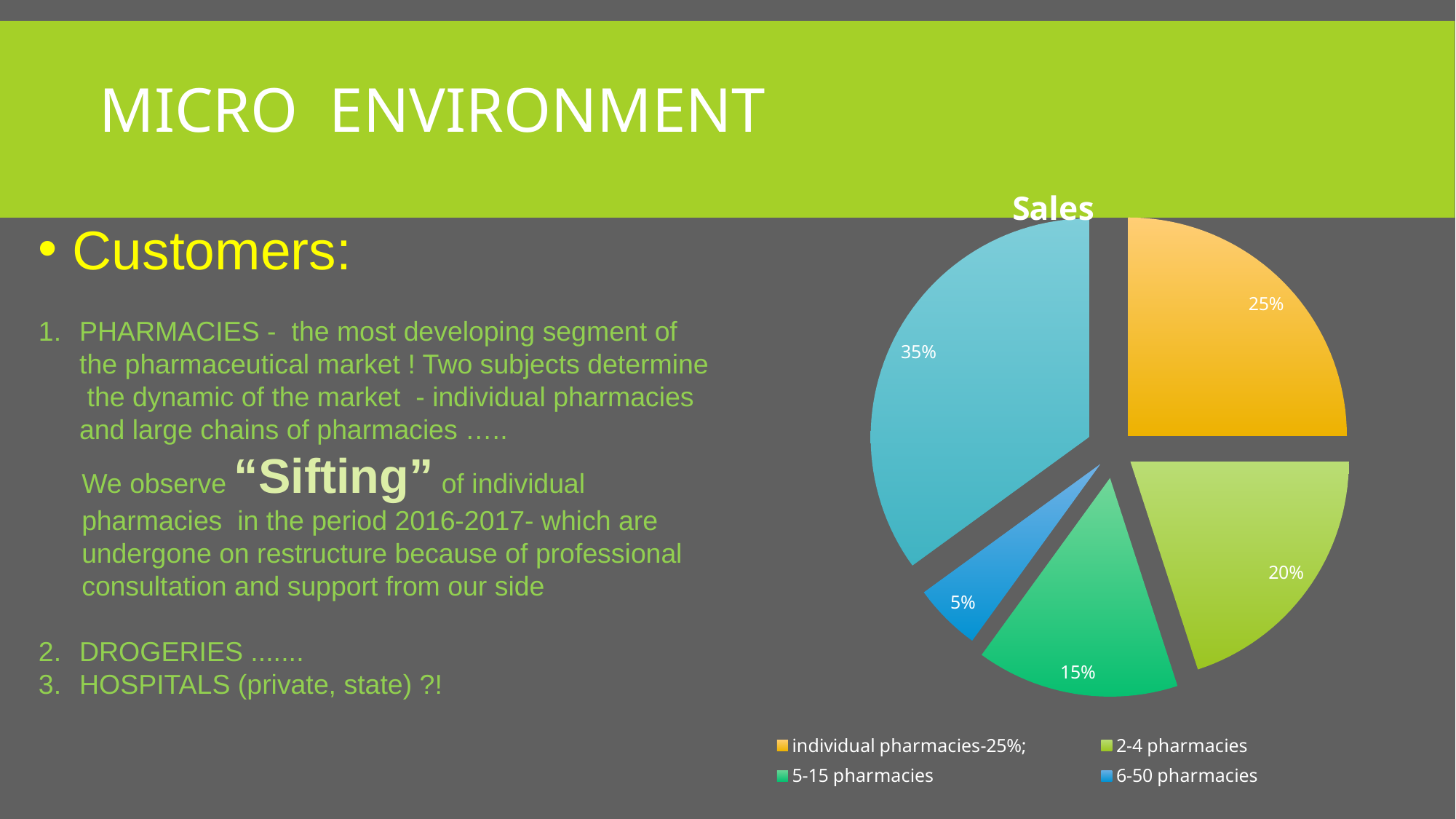
What share of the pie does the '2-4 pharmacies' slice represent? 20% How many entries does the legend list? 4 What share of the pie does the '6-50 pharmacies' slice represent? 5% What is the title of the chart? Sales What is the difference between the '2-4 pharmacies' slice and the '5-15 pharmacies' slice? 5% What share of the pie does the 'individual pharmacies-25%;' slice represent? 25% What share of the pie does the '5-15 pharmacies' slice represent? 15% Which legend category has the smallest slice of the pie? 6-50 pharmacies How many slices does the pie chart have? 5 What type of chart is shown on the slide? pie chart Which slice is larger, '2-4 pharmacies' or '6-50 pharmacies'? 2-4 pharmacies What is the percentage shown on the largest slice of the pie? 35%